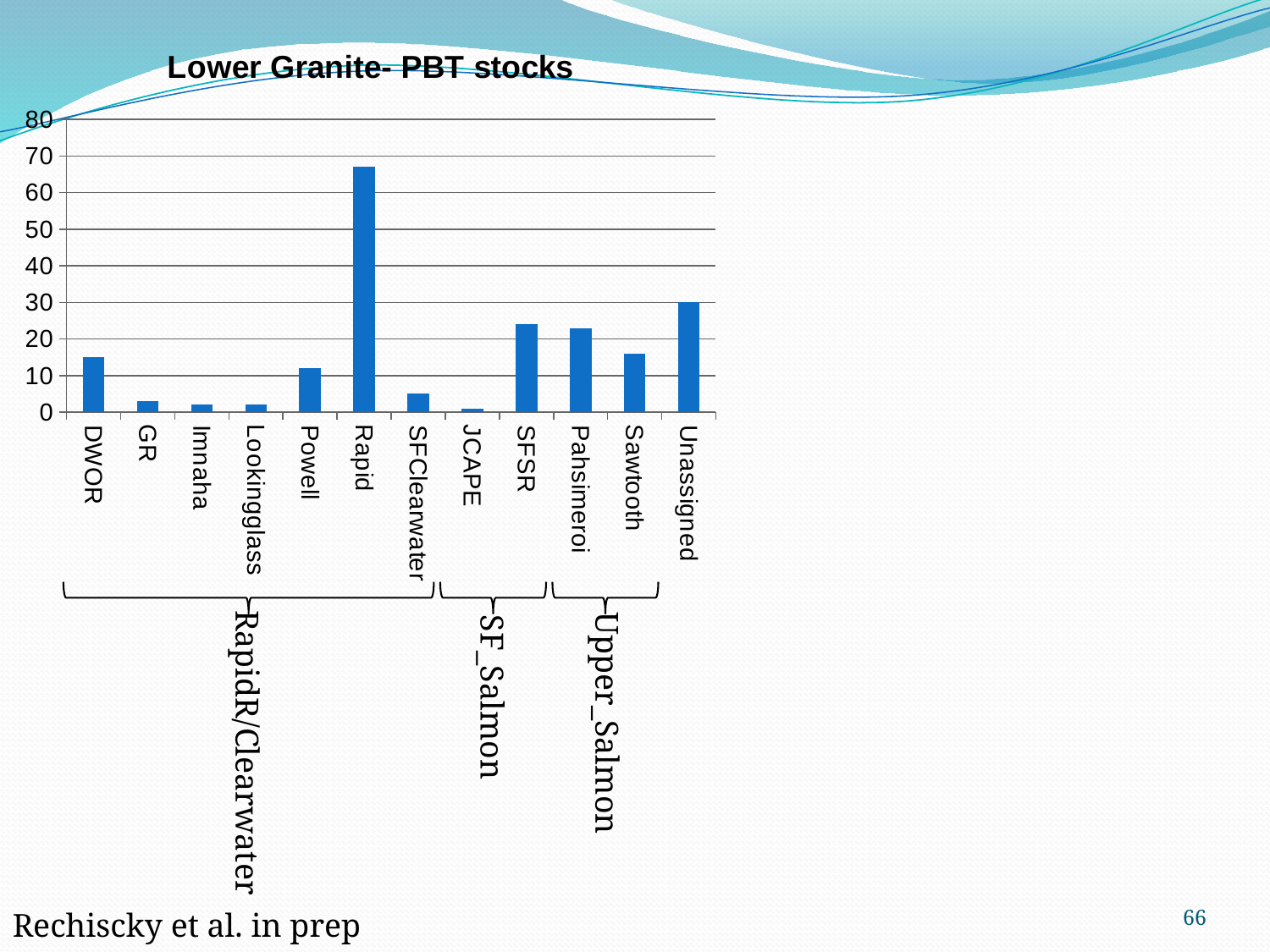
Which group bracket below the x axis covers the stocks from DWOR to SFClearwater? RapidR/Clearwater What type of chart is shown on the slide? bar chart Is the value for SFClearwater greater or less than 10? less Is the value for SFSR greater or less than 20? greater Is the value for DWOR greater or less than 20? less Which is larger, the value for Unassigned or the value for SFSR? Unassigned What is the title of the chart? Lower Granite- PBT stocks How many categories (stocks) are plotted on the x axis? 12 Which stock has the lowest value? JCAPE Which stock has the highest value? Rapid Which is larger, the value for Rapid or the value for Unassigned? Rapid